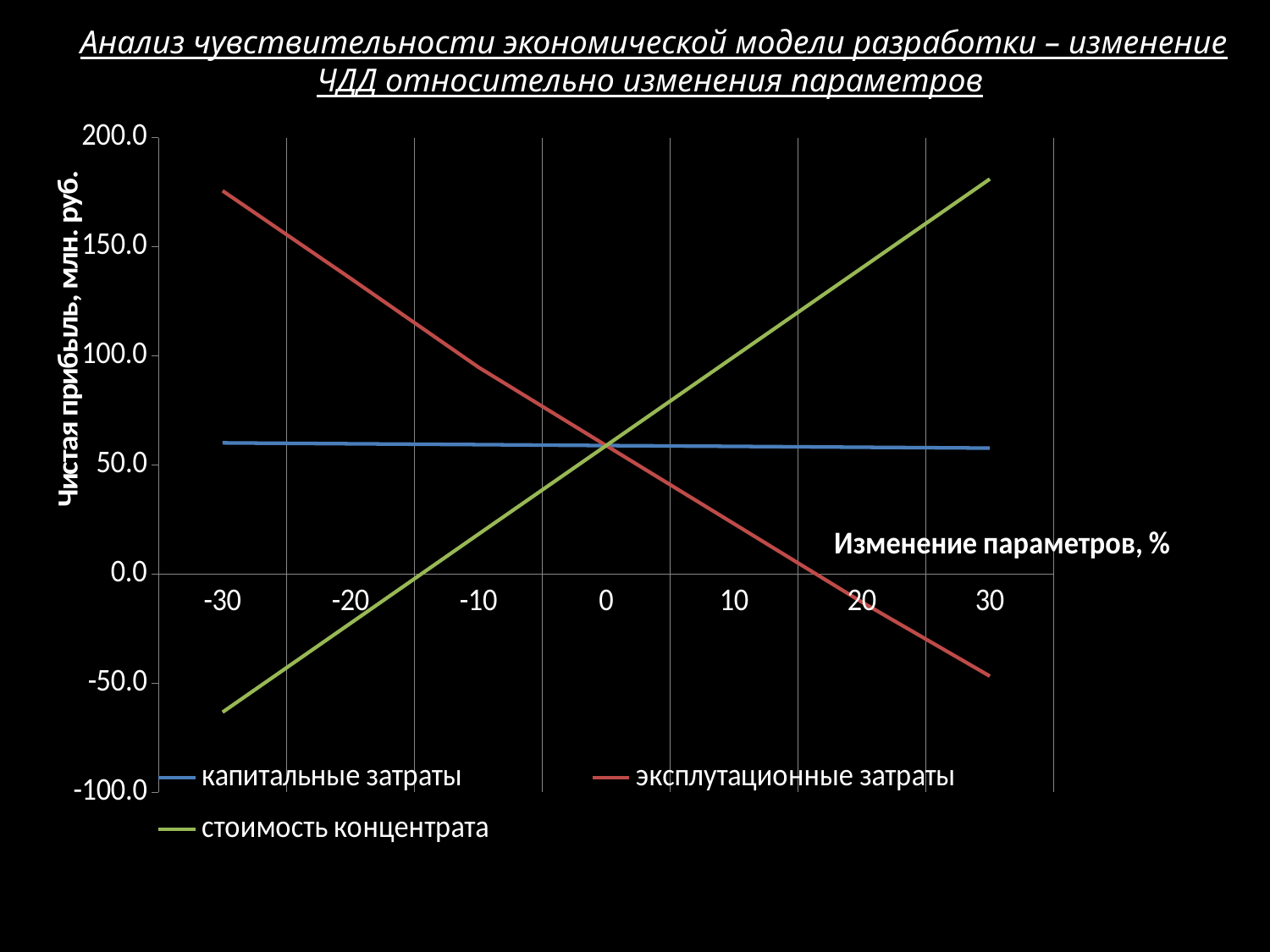
At a parameter change of -30, which series has the higher value: эксплутационные затраты or стоимость концентрата? эксплутационные затраты Which series does the red line represent? эксплутационные затраты How many series does the legend list? 3 Is the value for эксплутационные затраты at a parameter change of 30 greater or less than 0.0? less At a parameter change of 20, which series has the higher value: капитальные затраты or эксплутационные затраты? капитальные затраты Does the line for эксплутационные затраты rise or fall as the parameter change increases from -30 to 30? fall Does the line for стоимость концентрата rise or fall as the parameter change increases from -30 to 30? rise Is the value for капитальные затраты at a parameter change of 0 greater or less than 50.0? greater Which series does the green line represent? стоимость концентрата Is the value for стоимость концентрата at a parameter change of -30 greater or less than -50.0? less What kind of chart is shown on the slide? line chart